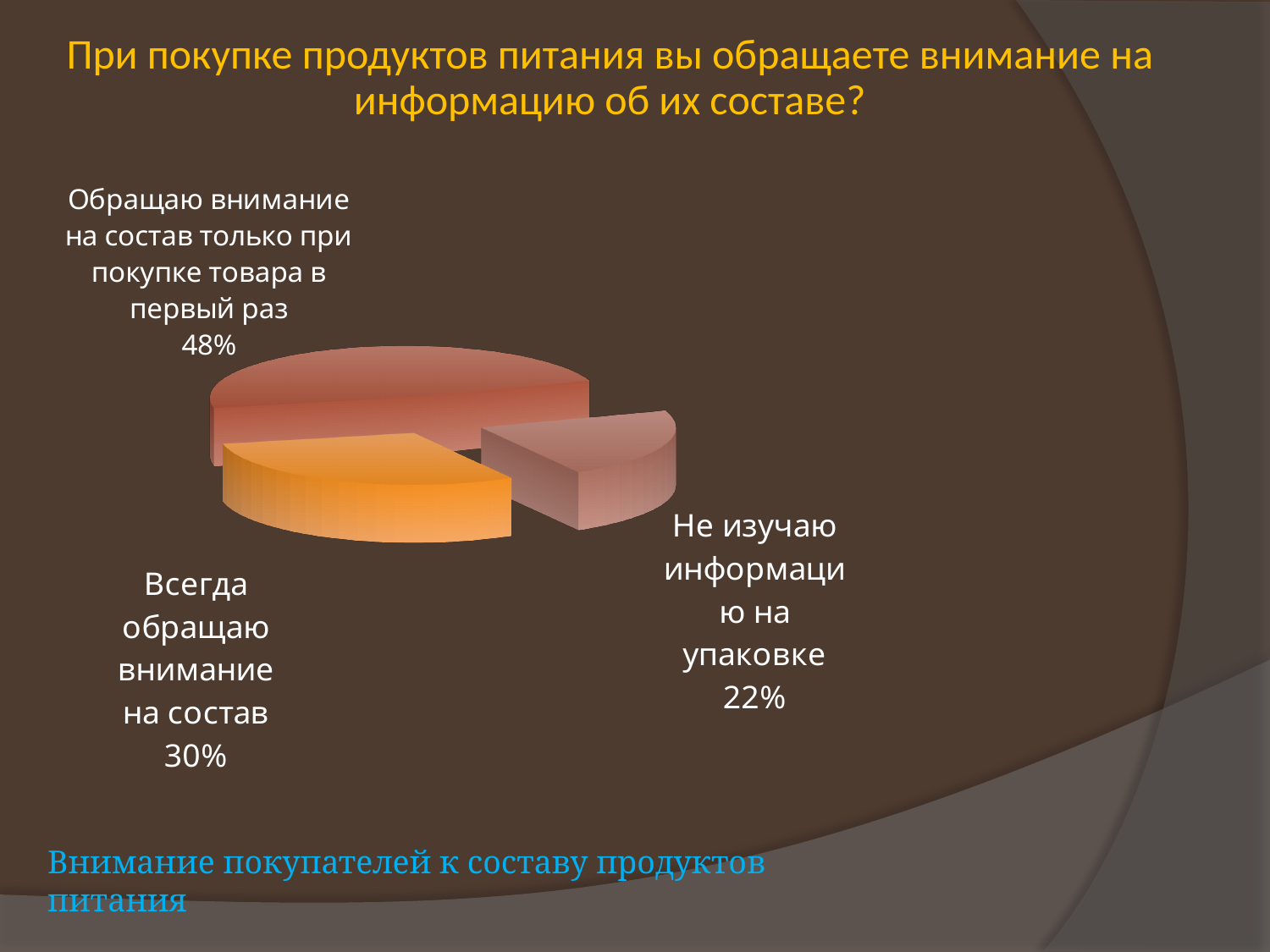
Which answer option has the largest share of the pie? Обращаю внимание на состав только при покупке товара в первый раз What is the difference in percentage points between "Обращаю внимание на состав только при покупке товара в первый раз" and "Всегда обращаю внимание на состав"? 18% Which answer option has the smallest share of the pie? Не изучаю информацию на упаковке Which is larger: the share for "Всегда обращаю внимание на состав" or for "Не изучаю информацию на упаковке"? Всегда обращаю внимание на состав How many slices does the pie chart have? 3 What is the title of the chart at the top of the slide? При покупке продуктов питания вы обращаете внимание на информацию об их составе? What share of respondents answered "Всегда обращаю внимание на состав"? 30% What is the difference in percentage points between "Всегда обращаю внимание на состав" and "Не изучаю информацию на упаковке"? 8% What share of respondents answered "Не изучаю информацию на упаковке"? 22% What type of chart is shown on the slide? Pie chart What share of respondents answered "Обращаю внимание на состав только при покупке товара в первый раз"? 48% What colour is the slice for "Всегда обращаю внимание на состав"? Orange